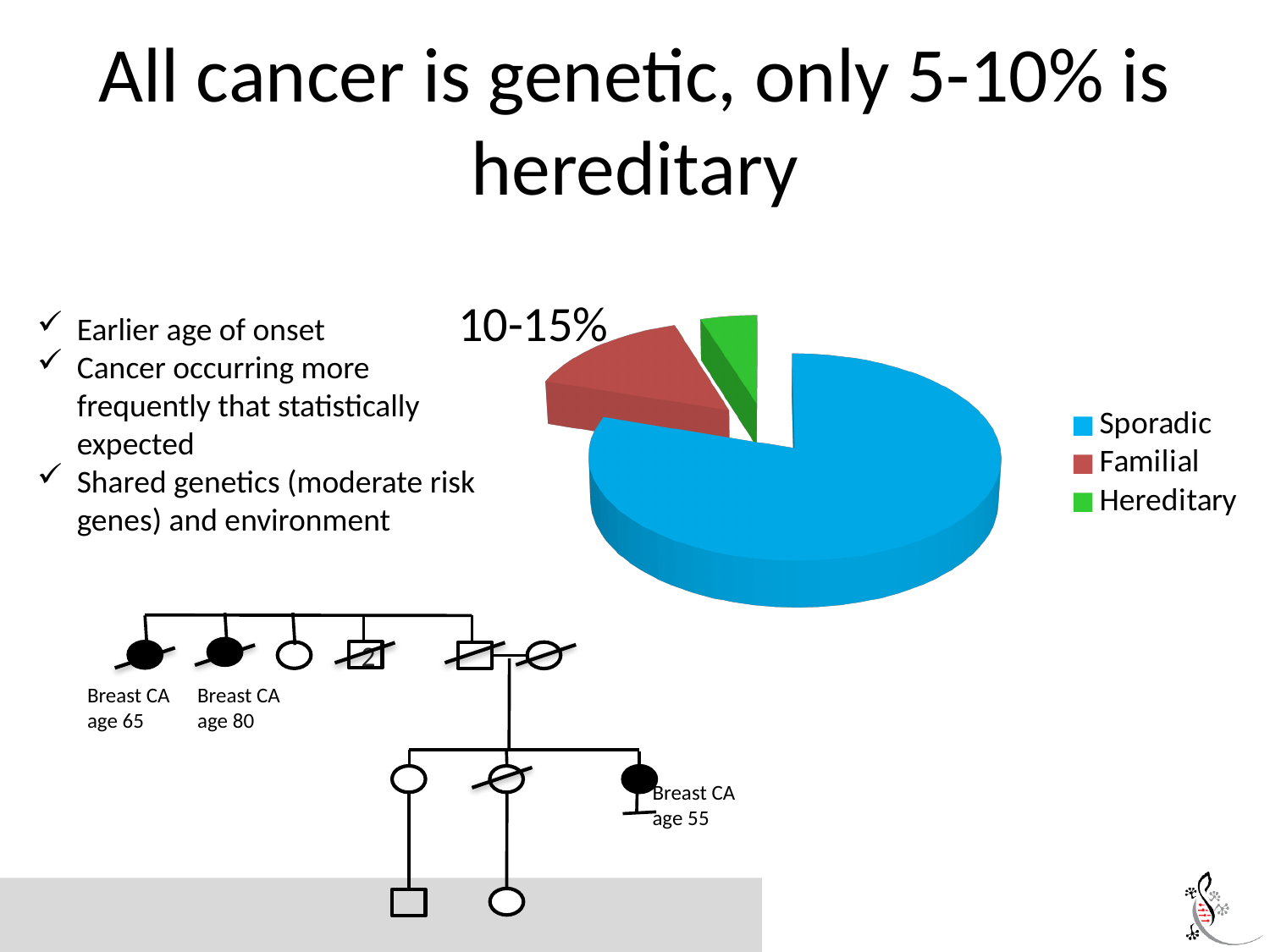
How many entries does the pie chart's legend list? 3 How many slices does the pie chart have? 3 Which slice is larger in the pie chart, Familial or Hereditary? Familial Which category has the smallest slice of the pie chart? Hereditary What colour is the Hereditary slice in the pie chart? green Which category has the largest slice of the pie chart? Sporadic Which slice is larger in the pie chart, Sporadic or Familial? Sporadic What colour is the Sporadic slice in the pie chart? blue What kind of chart is shown on the slide? pie chart What percentage label is printed next to the Familial slice of the pie chart? 10-15%